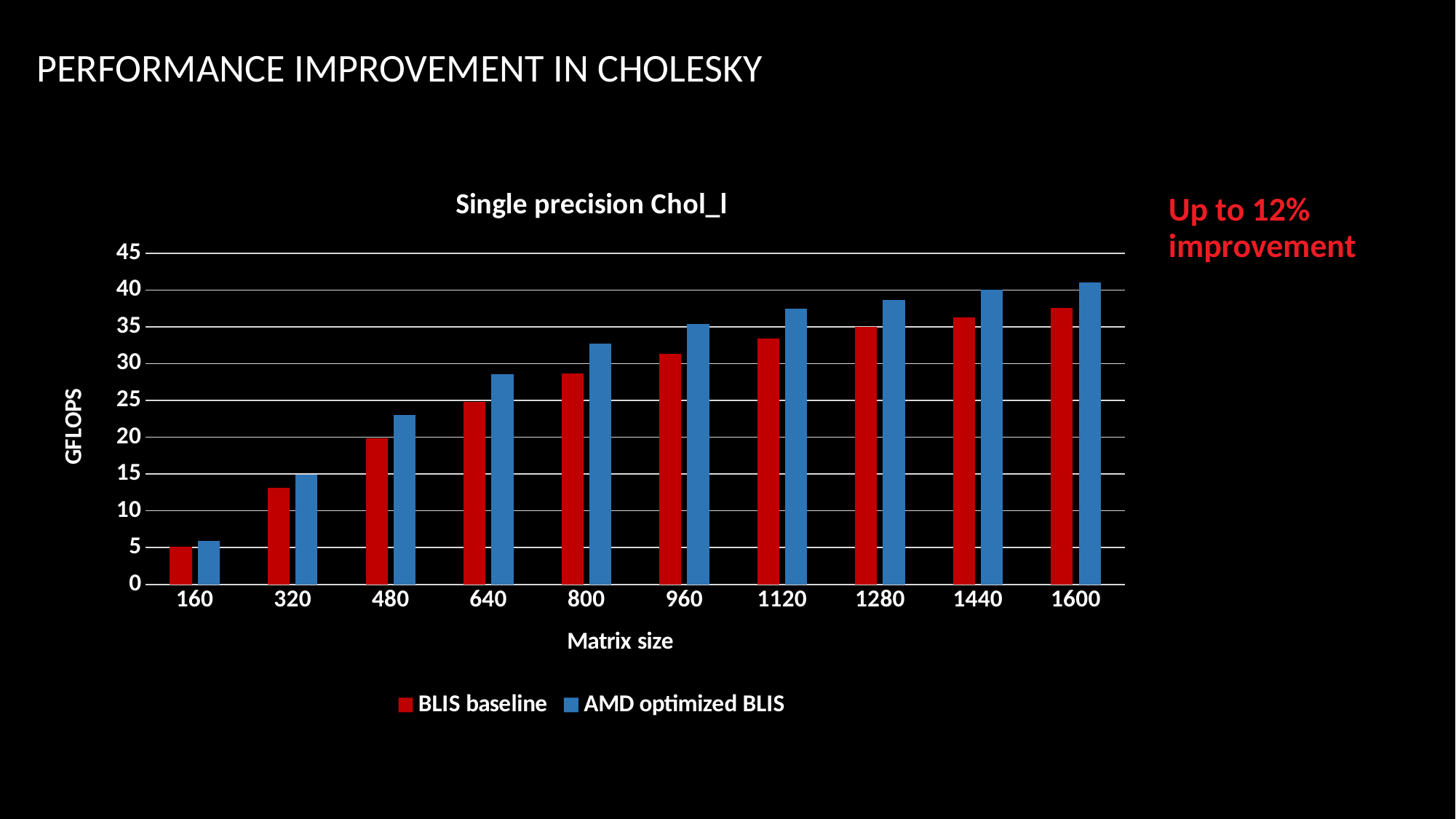
Is the AMD optimized BLIS value for matrix size 800 greater or less than 30? greater Which matrix size has the lowest BLIS baseline value? 160 At matrix size 1280, which series has the larger value, BLIS baseline or AMD optimized BLIS? AMD optimized BLIS What type of chart is shown on the slide? bar chart Which matrix size has the highest AMD optimized BLIS value? 1600 What is the label of the y axis? GFLOPS Do the BLIS baseline values rise or fall as matrix size increases? rise Is the BLIS baseline value for matrix size 960 greater or less than 35? less Is the AMD optimized BLIS value for matrix size 1600 greater or less than 40? greater What is the title of the chart? Single precision Chol_l How many series does the legend list? 2 How many matrix sizes are shown on the x axis? 10